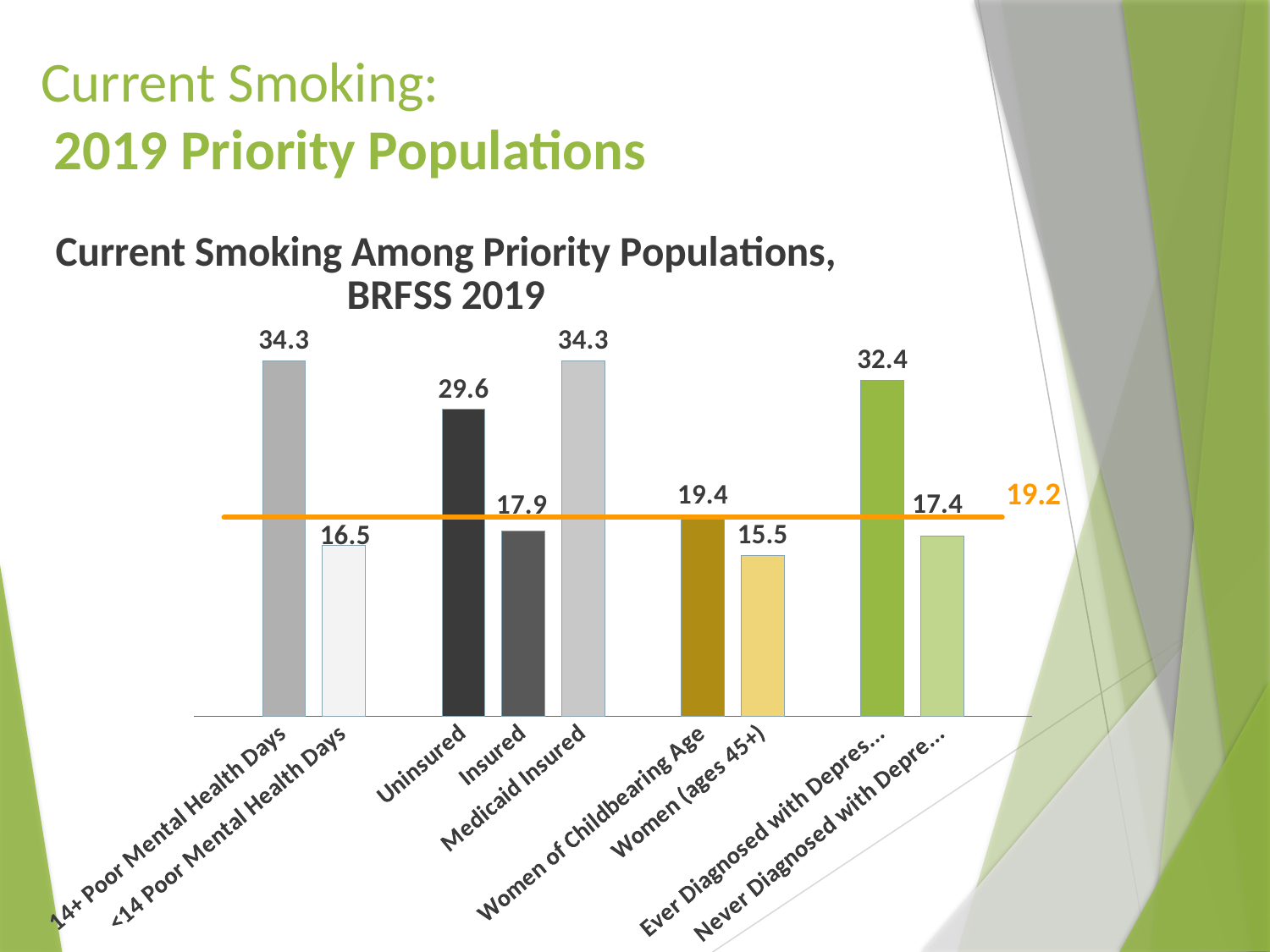
What kind of chart is shown on the slide? Bar chart What is the value shown for Women (ages 45+)? 15.5 What is the difference between the values for 14+ Poor Mental Health Days and <14 Poor Mental Health Days? 17.8 What is the value shown for <14 Poor Mental Health Days? 16.5 Which is larger, the value for Insured or the value for Uninsured? Uninsured What value is labeled on the orange horizontal reference line? 19.2 Which is larger, the value for Women of Childbearing Age or the value for Women (ages 45+)? Women of Childbearing Age What is the value shown for Medicaid Insured? 34.3 Which category has the lowest value in the chart? Women (ages 45+) What is the difference between the values for Uninsured and Insured? 11.7 How many bars are plotted in the chart? 9 What is the current smoking value for Uninsured? 29.6